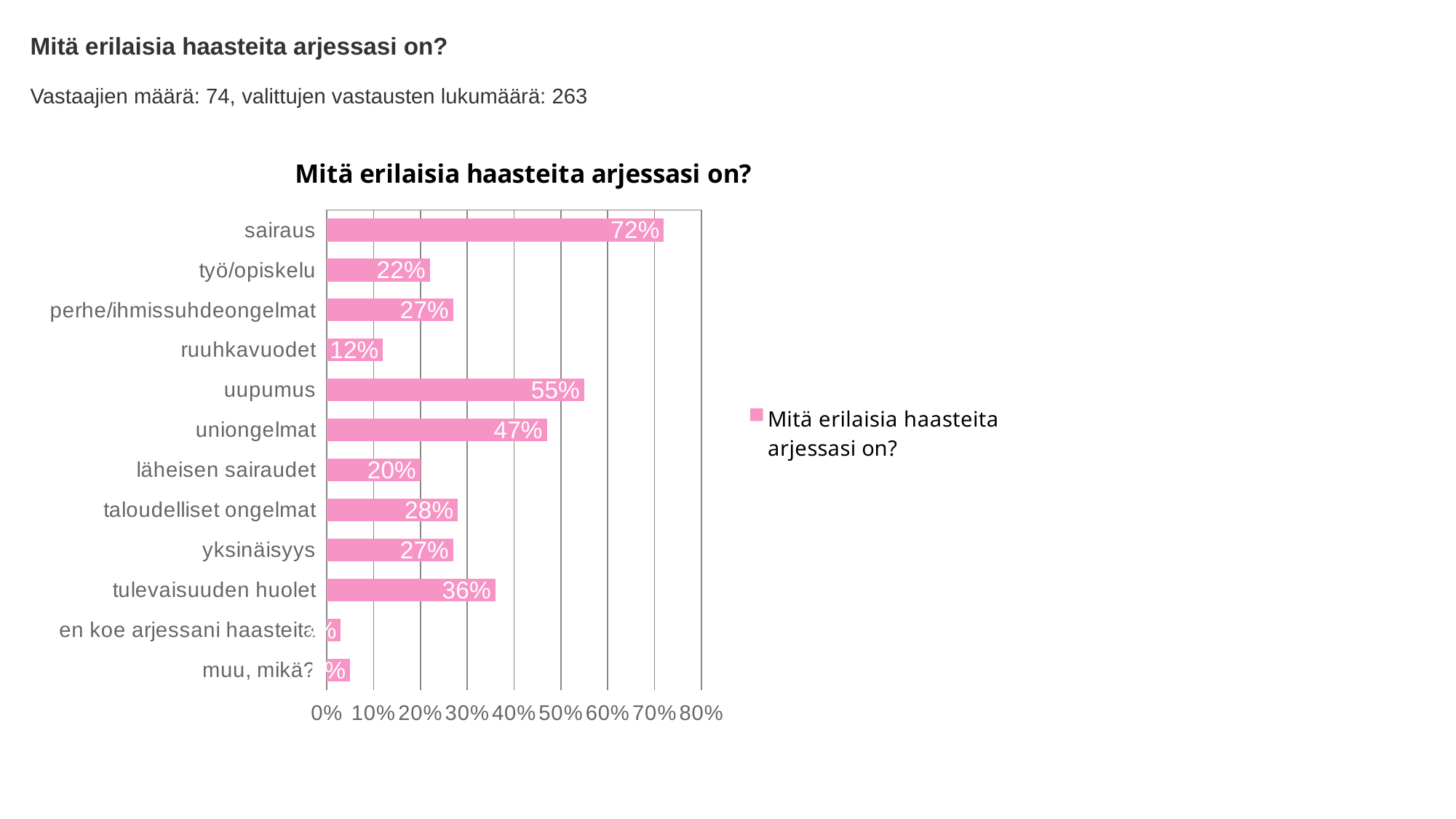
What is the difference between the values for uniongelmat and läheisen sairaudet? 27% What kind of chart is shown on the slide? bar chart How many series does the legend list? 1 What is the value for tulevaisuuden huolet? 36% Which is larger, the value for taloudelliset ongelmat or the value for työ/opiskelu? taloudelliset ongelmat Which category has the highest value? sairaus What is the value for sairaus? 72% Is the value for uniongelmat greater or less than 40%? greater What is the value for ruuhkavuodet? 12% How many categories are shown in the chart? 12 What is the value for uupumus? 55% What is the difference between the values for sairaus and uupumus? 17%